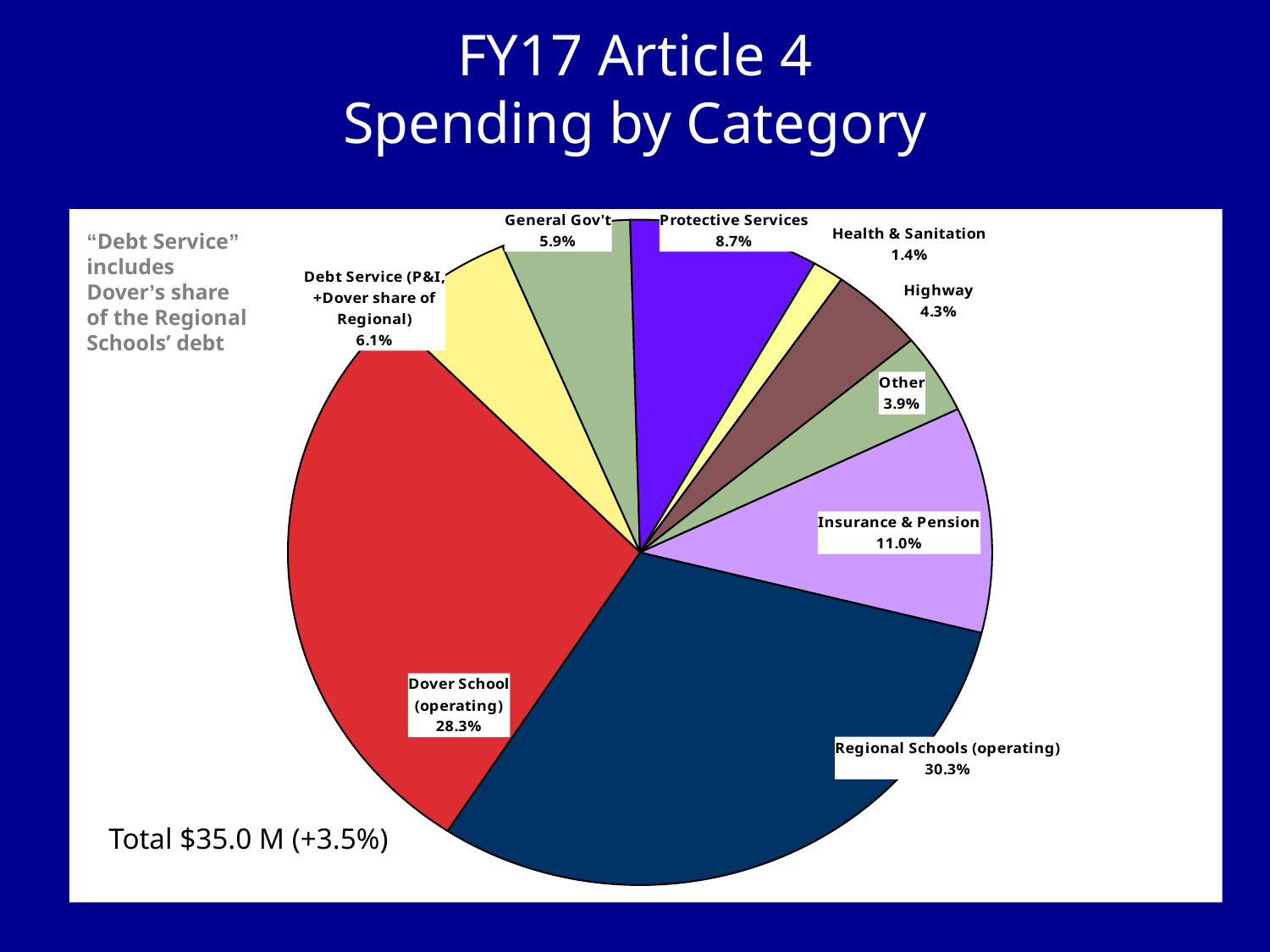
Which category has the largest share of spending? Regional Schools (operating) Which is larger, the share for Highway or the share for Other? Highway What type of chart is shown on the slide? Pie chart What percentage is shown for Health & Sanitation? 1.4% What total spending amount is stated on the slide? $35.0 M (+3.5%) What share of spending goes to Dover School (operating)? 28.3% Which category has the smallest share of spending? Health & Sanitation What percentage is shown for Insurance & Pension? 11.0% What percentage is shown for Protective Services? 8.7% What share of spending goes to Regional Schools (operating)? 30.3% What is the difference in percentage points between Regional Schools (operating) and Dover School (operating)? 2.0 percentage points How many categories are shown in the pie chart? 9